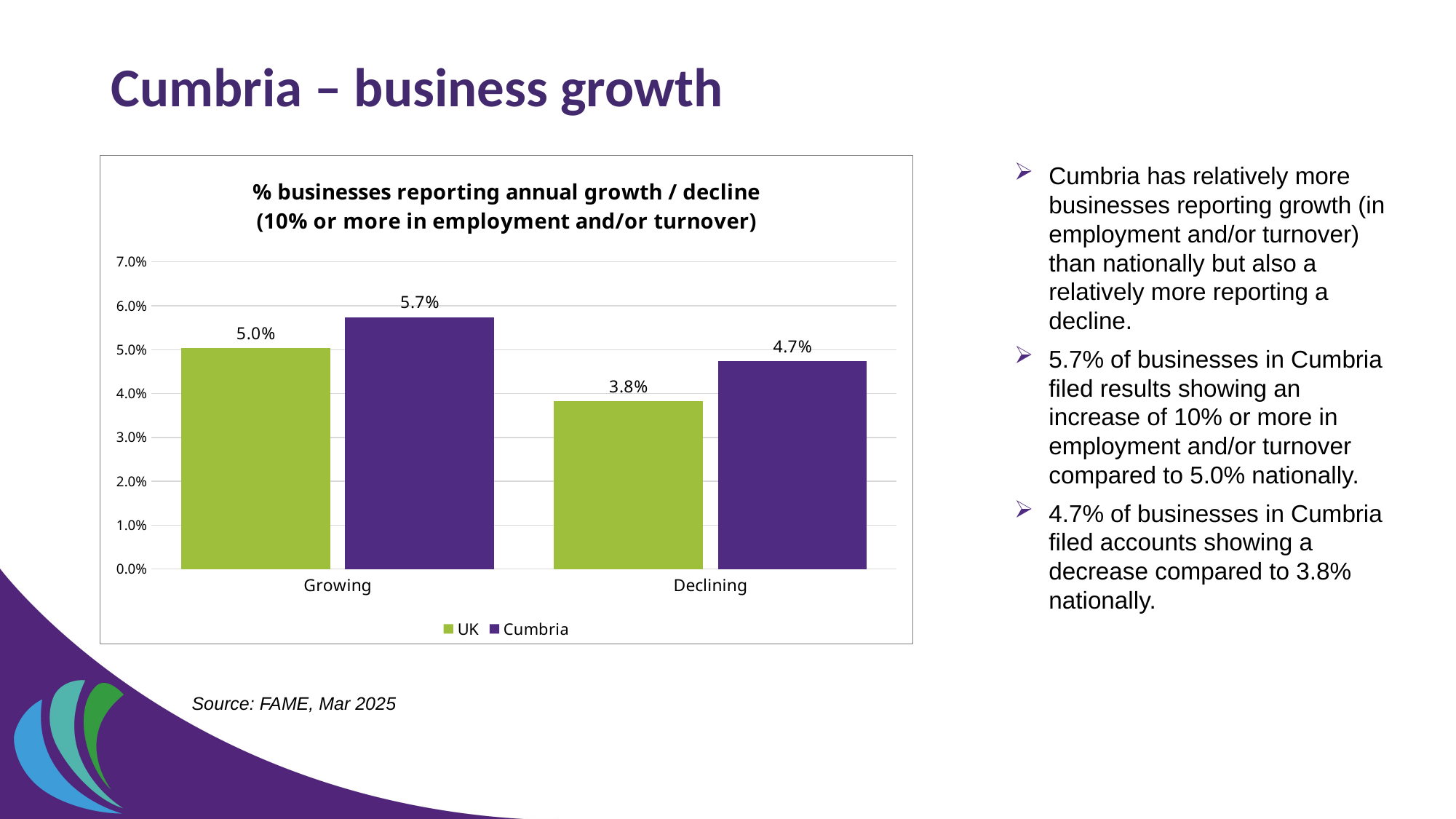
What is the difference between the Cumbria and UK values for Growing? 0.7% What kind of chart is shown on the slide? Bar chart What is the difference between the Cumbria and UK values for Declining? 0.9% What percentage of UK businesses are reporting growth? 5.0% For Declining, which is larger: the UK value or the Cumbria value? Cumbria Which bar in the chart has the highest value? Cumbria, Growing How many series does the legend list? 2 How many categories are shown on the x axis? 2 What percentage of UK businesses are reporting decline? 3.8% What percentage of Cumbria businesses are reporting growth? 5.7% Which bar in the chart has the lowest value? UK, Declining What percentage of Cumbria businesses are reporting decline? 4.7%